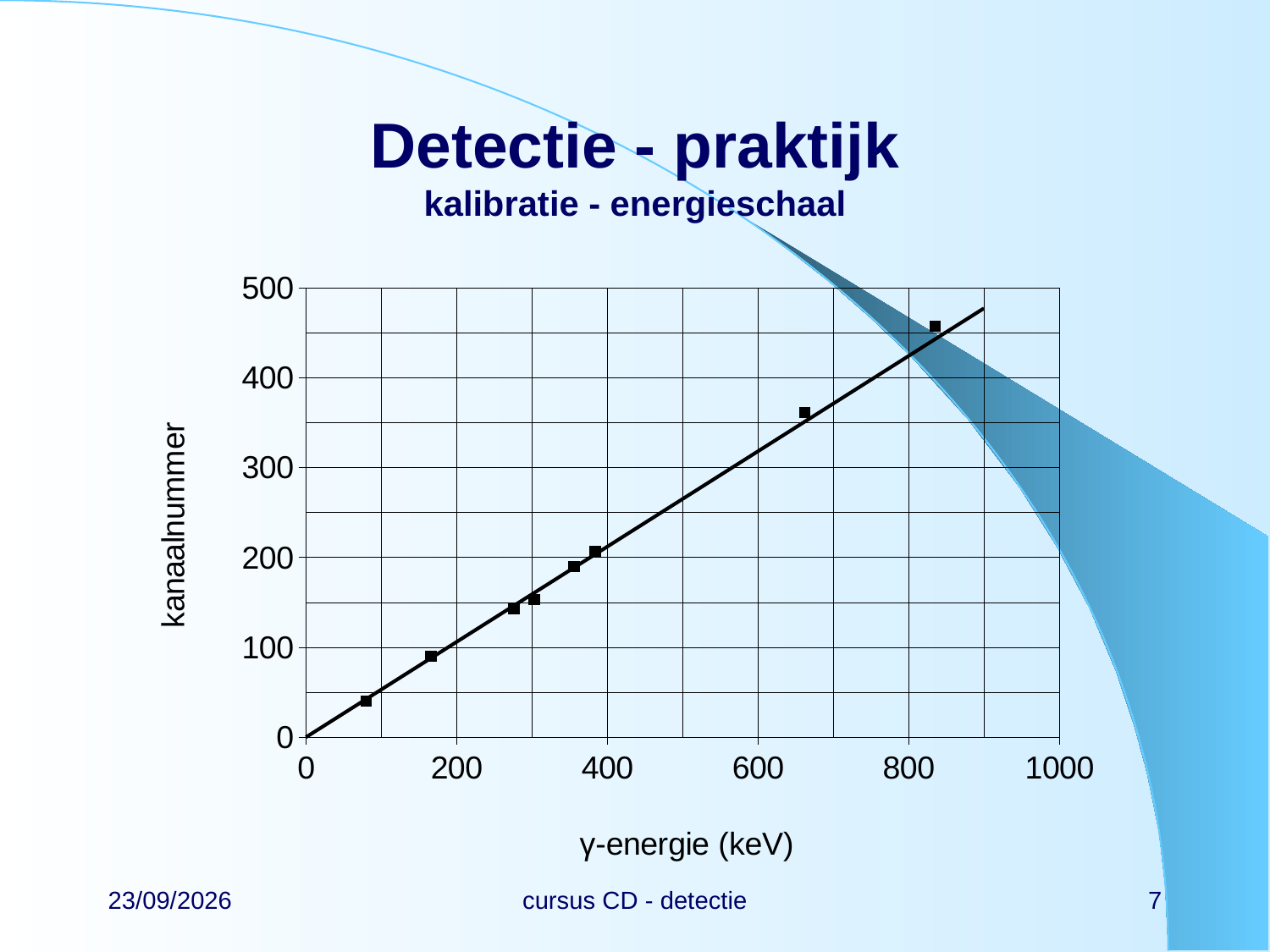
Is the channel number of the data point near 170 keV greater or less than 200? less Do the channel numbers rise or fall as the γ-energy increases along the x axis? rise Is the channel number of the lowest data point (near 80 keV) greater or less than 100? less Is the channel number of the data point near 660 keV greater or less than 400? less How many data points are plotted on the chart? 8 What is the label of the x axis? γ-energie (keV) Which data point has the highest channel number: the one near 660 keV or the one near 830 keV? the one near 830 keV What is the label of the y axis? kanaalnummer What kind of chart is shown on the slide? scatter chart What is the maximum value shown on the x axis? 1000